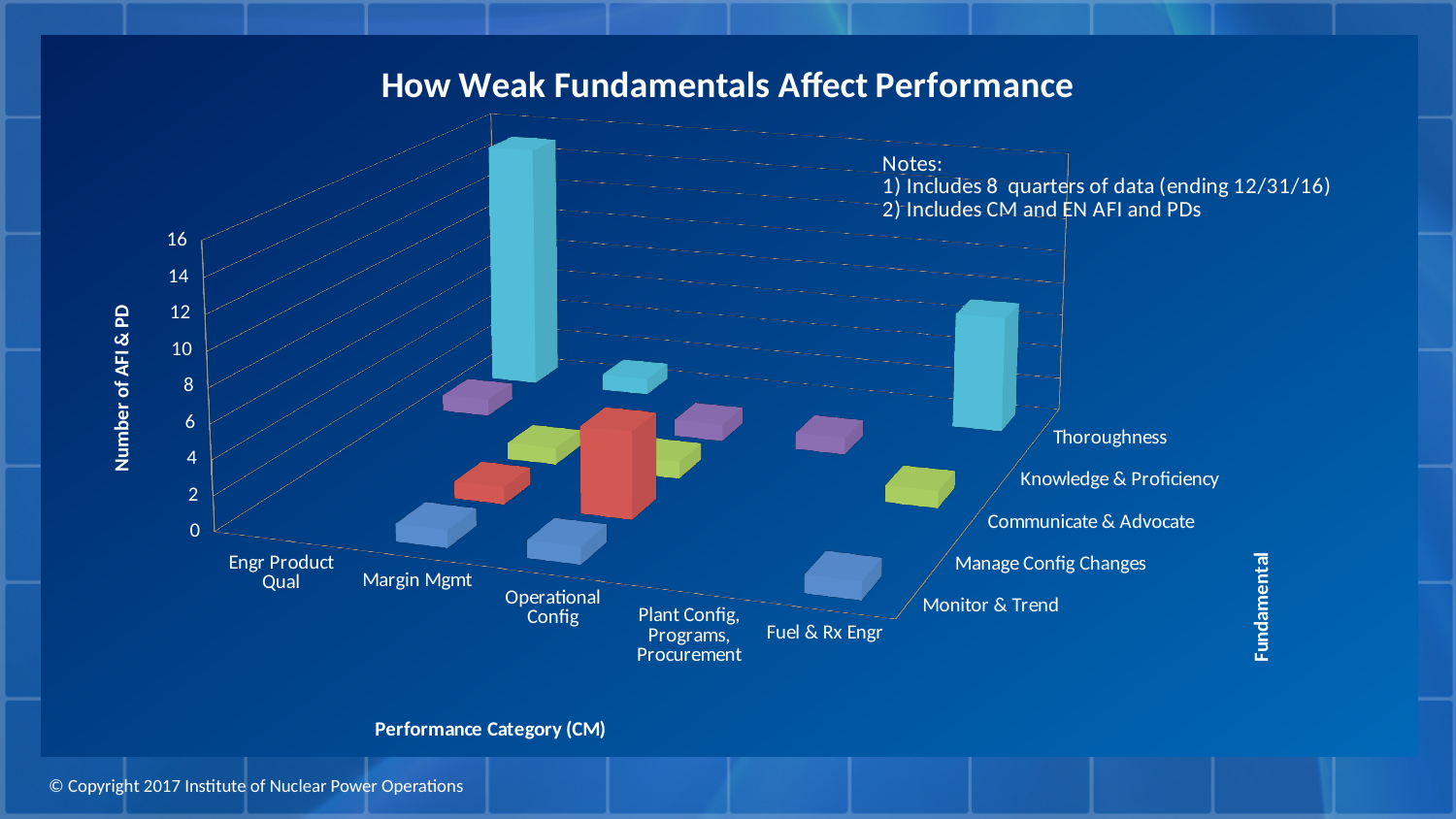
Which is larger: the Thoroughness bar for Margin Mgmt or the Thoroughness bar for Fuel & Rx Engr? Fuel & Rx Engr How many fundamentals are listed along the Fundamental axis? 5 Which performance category has the tallest bar in the chart? Engr Product Qual What kind of chart is shown on the slide? bar chart What is the label of the vertical axis? Number of AFI & PD Is the value for Fuel & Rx Engr under Thoroughness greater or less than 2? greater Is the value for Margin Mgmt under Thoroughness greater or less than 10? less How many performance categories are shown along the Performance Category (CM) axis? 5 Which fundamental has the tallest bar in the chart? Thoroughness What is the title of the chart? How Weak Fundamentals Affect Performance What is the maximum value shown on the vertical axis? 16